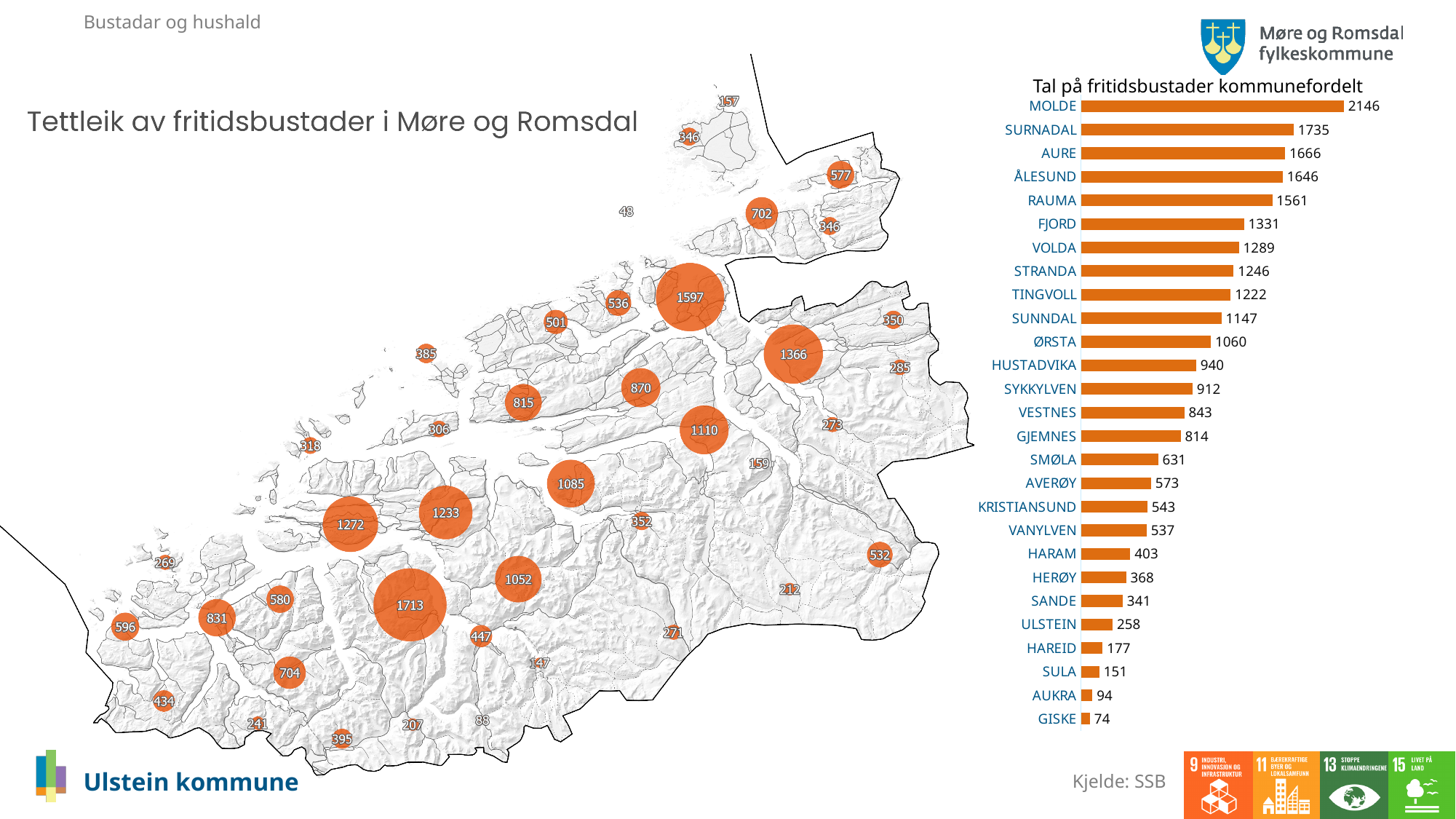
In the bar chart 'Tal på fritidsbustader kommunefordelt', which is larger, the value for RAUMA or the value for FJORD? RAUMA What kind of chart is 'Tal på fritidsbustader kommunefordelt'? Bar chart In the bar chart 'Tal på fritidsbustader kommunefordelt', what is the value for VOLDA? 1289 In the bar chart 'Tal på fritidsbustader kommunefordelt', which is larger, the value for HERØY or the value for SANDE? HERØY In the bar chart 'Tal på fritidsbustader kommunefordelt', what is the difference between SURNADAL and AURE? 69 In the bar chart 'Tal på fritidsbustader kommunefordelt', what is the value for ULSTEIN? 258 In the bar chart 'Tal på fritidsbustader kommunefordelt', which municipality has the lowest value? GISKE In the bar chart 'Tal på fritidsbustader kommunefordelt', what is the value for MOLDE? 2146 What is the title of the bar chart on the right side of the slide? Tal på fritidsbustader kommunefordelt How many municipalities are listed in the bar chart 'Tal på fritidsbustader kommunefordelt'? 27 In the bar chart 'Tal på fritidsbustader kommunefordelt', what is the difference between HAREID and ULSTEIN? 81 In the bar chart 'Tal på fritidsbustader kommunefordelt', which municipality has the highest value? MOLDE